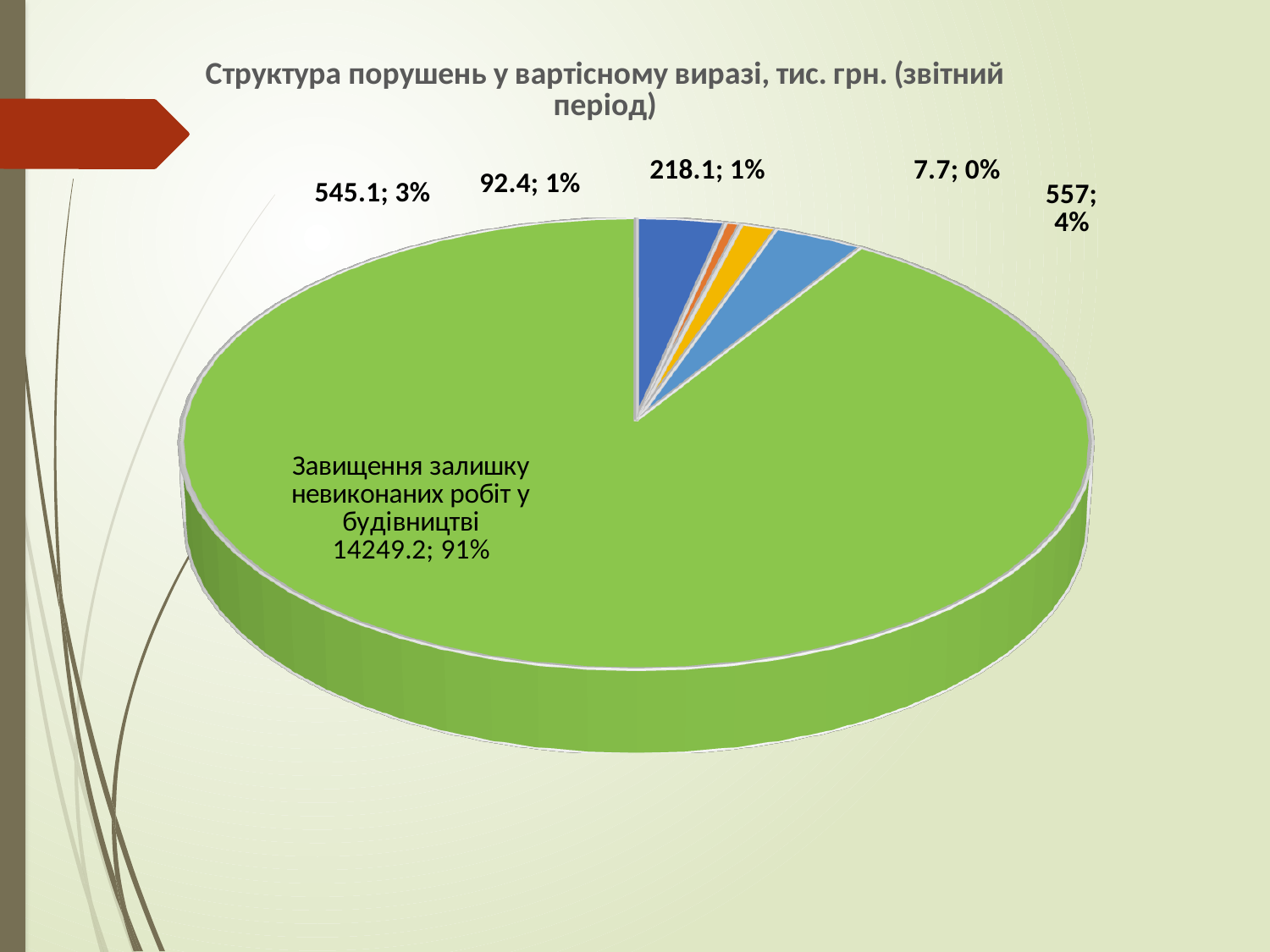
Which slice is the largest in the pie chart? Завищення залишку невиконаних робіт у будівництві What percentage is shown for the slice with value 557? 4% What is the title of the chart? Структура порушень у вартісному виразі, тис. грн. (звітний період) What colour is the largest slice of the pie chart? Green Which is larger: the slice labeled 545.1 or the slice labeled 557? 557 What is the value shown for "Завищення залишку невиконаних робіт у будівництві"? 14249.2 How many slices does the pie chart have? 6 What share of the pie does "Завищення залишку невиконаних робіт у будівництві" represent? 91% What is the difference between the value for "Завищення залишку невиконаних робіт у будівництві" and the slice labeled 557? 13692.2 What percentage is shown for the slice with value 545.1? 3% What is the smallest value labeled on the pie chart? 7.7 What kind of chart is shown on the slide? Pie chart